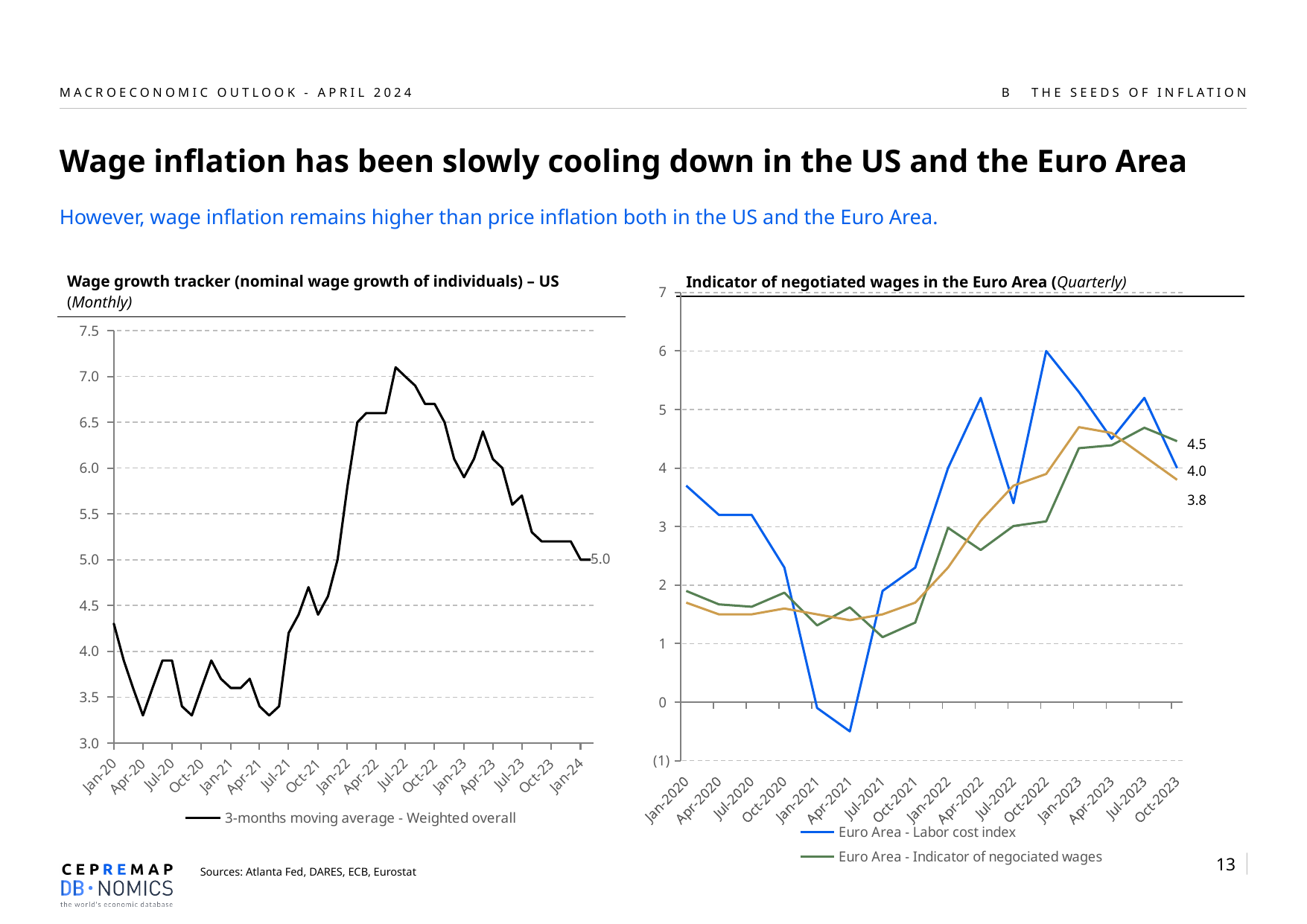
In the left chart 'Wage growth tracker – US', do the values rise or fall from Jul-22 to Jan-24? fall In the left chart 'Wage growth tracker – US', what is the value at Jan-24? 5.0 In the left chart 'Wage growth tracker – US', is the value at Apr-22 greater or less than 6.0? greater How many series does the legend of the left chart 'Wage growth tracker – US' list? 1 What is the legend entry of the left chart 'Wage growth tracker – US'? 3-months moving average - Weighted overall In the right chart 'Indicator of negotiated wages in the Euro Area', what is the value of 'Euro Area - Indicator of negotiated wages' at Oct-2023? 4.5 What kind of chart is the left chart, 'Wage growth tracker (nominal wage growth of individuals) – US'? Line chart In the right chart 'Indicator of negotiated wages in the Euro Area', what is the difference between the Indicator of negotiated wages and the Labor cost index at Oct-2023? 0.5 How many series does the legend of the right chart 'Indicator of negotiated wages in the Euro Area' list? 2 In the right chart 'Indicator of negotiated wages in the Euro Area', is the 'Euro Area - Labor cost index' value at Apr-2021 greater or less than 0? less In the left chart 'Wage growth tracker – US', is the value at Apr-20 greater or less than 3.5? less In the right chart 'Indicator of negotiated wages in the Euro Area', what is the value of 'Euro Area - Labor cost index' at Oct-2023? 4.0